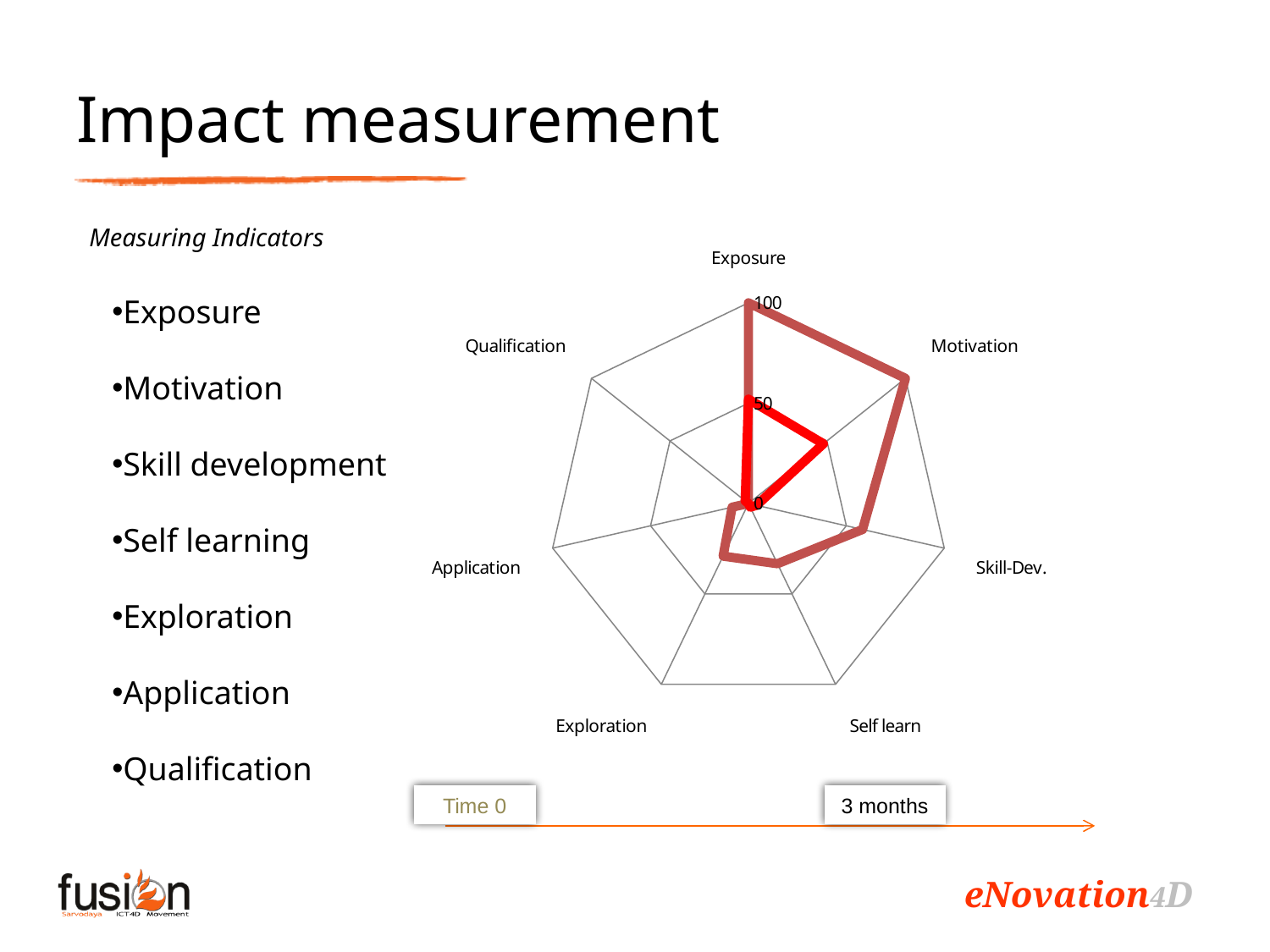
On the radar chart, is the Qualification value for the larger, darker red outline greater or less than 50? less On the radar chart, which outline has the larger Skill-Dev. value, the darker red one or the bright red one? the darker red one How many indicator axes does the radar chart have? 7 What kind of chart is shown on the slide? radar chart How many data series are plotted on the radar chart? 2 On the radar chart, is the Motivation value for the larger, darker red outline greater or less than 50? greater What is the highest value shown on the radar chart's axis scale? 100 On the radar chart, what is the Exposure value for the larger, darker red outline? 100 On the radar chart, which indicator has the lowest value for the smaller, bright red outline: Exposure or Application? Application Which axis label appears at the top of the radar chart? Exposure